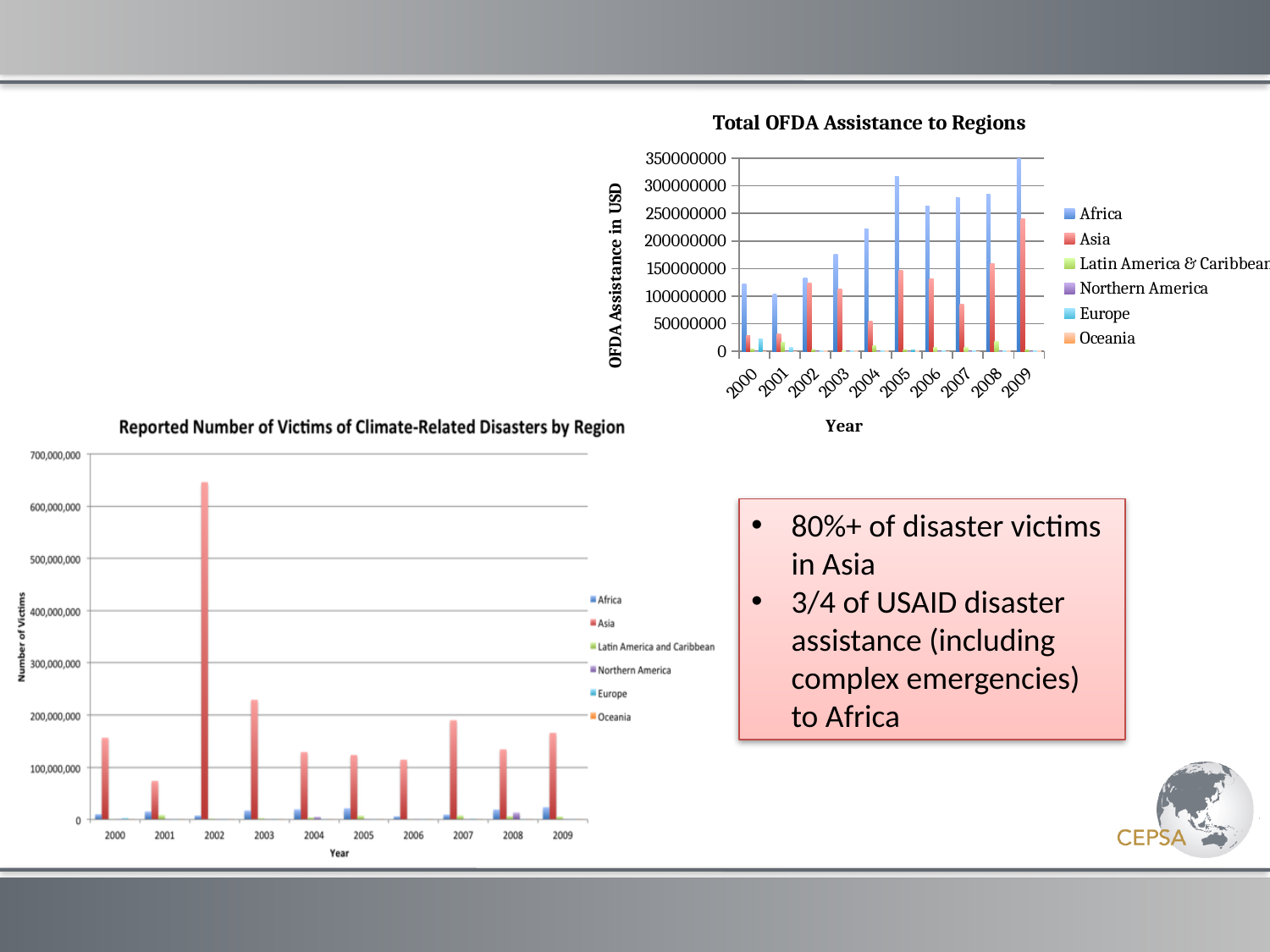
In the 'Total OFDA Assistance to Regions' chart, what is the label on the vertical axis? OFDA Assistance in USD In the 'Total OFDA Assistance to Regions' chart, in which year is the Africa bar highest? 2009 In the 'Total OFDA Assistance to Regions' chart, how many regions does the legend list? 6 In the 'Total OFDA Assistance to Regions' chart, what kind of chart is used? bar chart In the 'Reported Number of Victims of Climate-Related Disasters by Region' chart, is the value for Asia in 2001 greater or less than 100,000,000? less In the 'Total OFDA Assistance to Regions' chart, which region has the larger value in 2009, Africa or Asia? Africa In the 'Total OFDA Assistance to Regions' chart, how many years are shown on the x axis? 10 In the 'Reported Number of Victims of Climate-Related Disasters by Region' chart, in which year is the Asia bar highest? 2002 In the 'Total OFDA Assistance to Regions' chart, is the value for Asia in 2004 greater or less than 100000000? less In the 'Reported Number of Victims of Climate-Related Disasters by Region' chart, how many regions does the legend list? 6 In the 'Reported Number of Victims of Climate-Related Disasters by Region' chart, is the value for Asia in 2002 greater or less than 600,000,000? greater